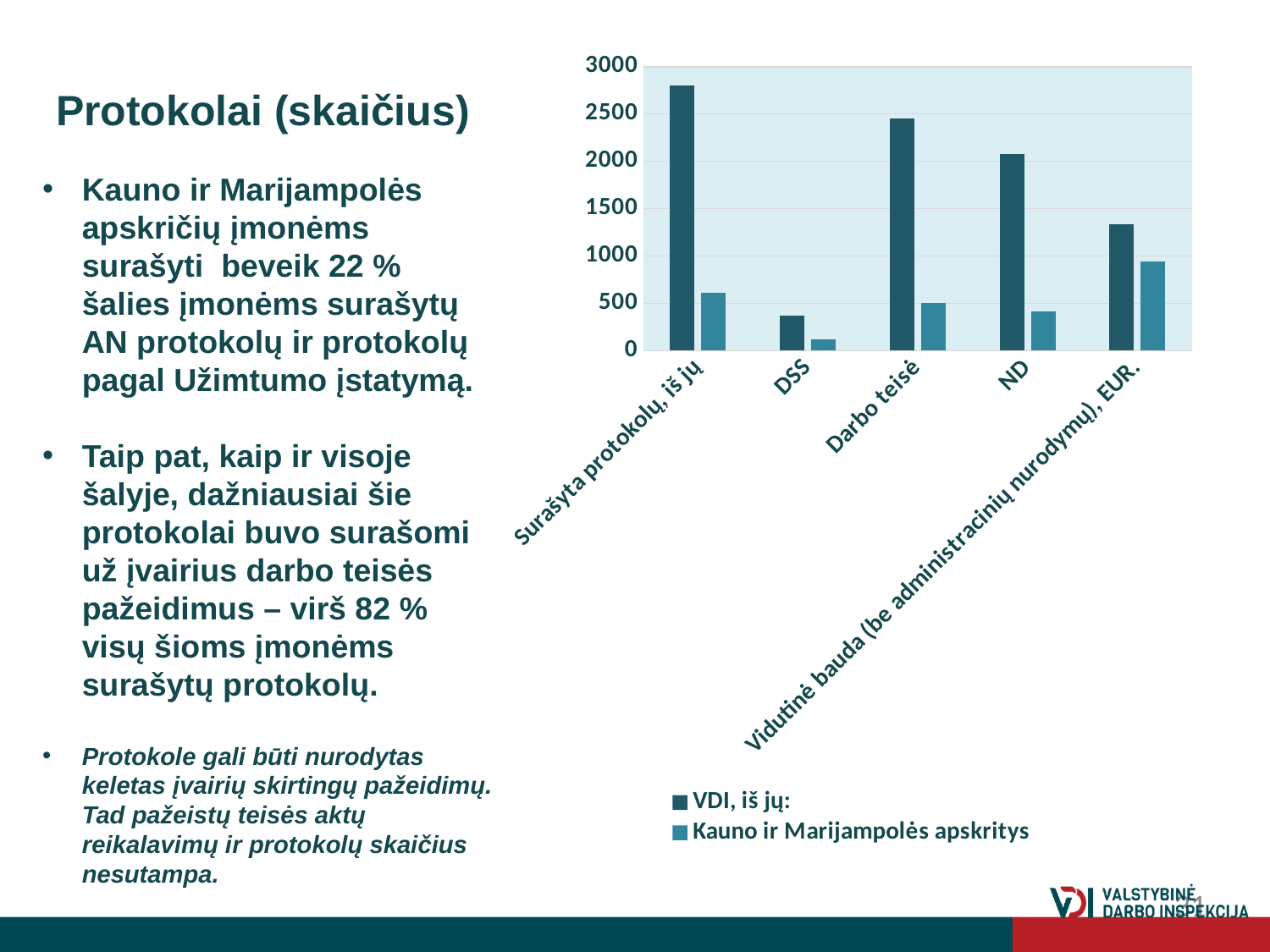
Which category has the highest value for the 'VDI, iš jų:' series? Surašyta protokolų, iš jų Is the 'VDI, iš jų:' value for 'Surašyta protokolų, iš jų' greater or less than 2500? greater What are the two series named in the chart legend? VDI, iš jų: and Kauno ir Marijampolės apskritys How many series does the chart legend list? 2 For the 'VDI, iš jų:' series, which is larger: 'Darbo teisė' or ND? Darbo teisė What kind of chart is shown on the slide? bar chart Is the 'Kauno ir Marijampolės apskritys' value for ND greater or less than 500? less Is the 'VDI, iš jų:' value for 'Darbo teisė' greater or less than 2000? greater How many categories are shown on the x axis of the chart? 5 Which category has the lowest value for the 'Kauno ir Marijampolės apskritys' series? DSS